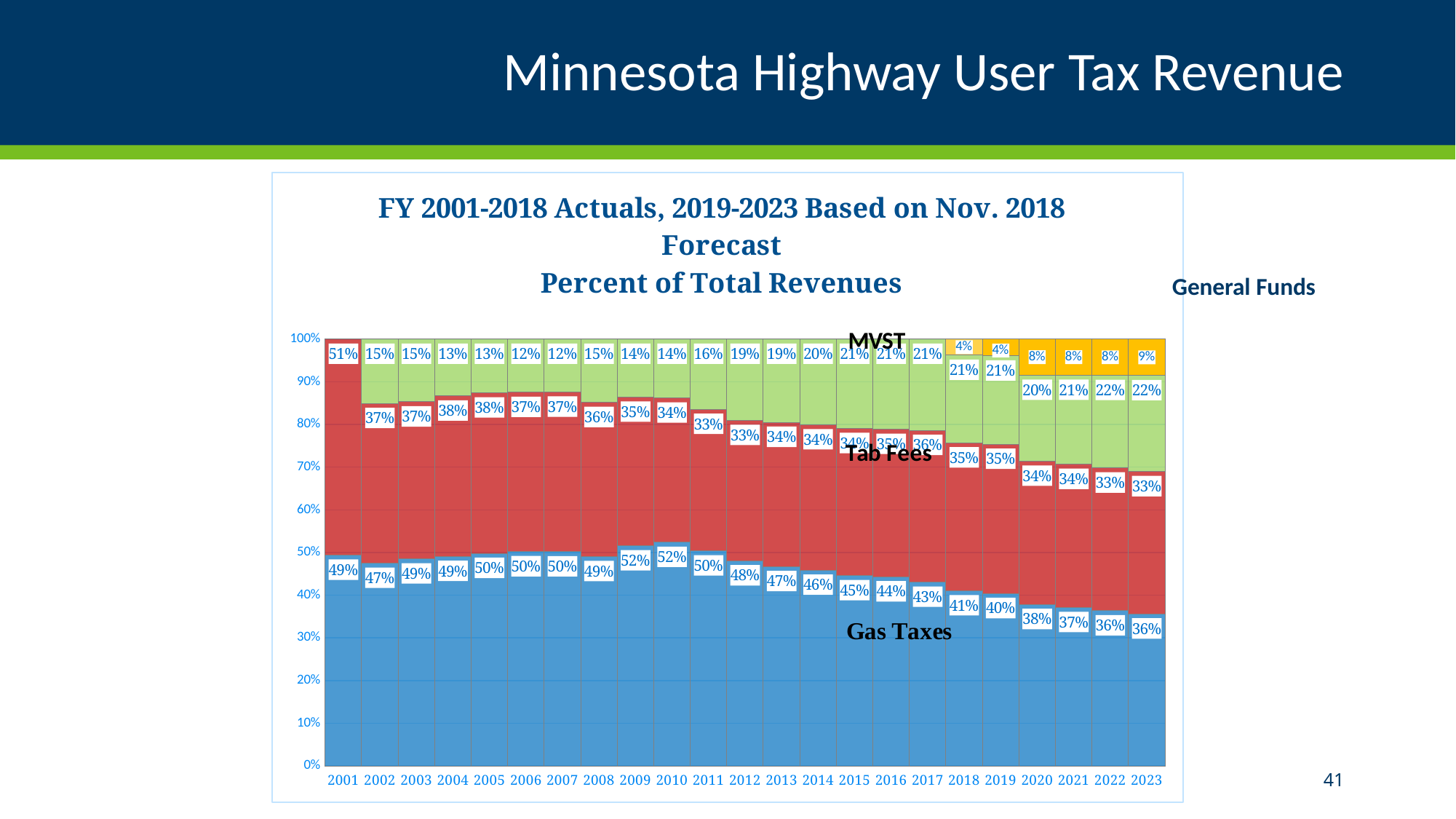
In which year is the Gas Taxes share lowest? 2022 and 2023 (36%) How many fiscal years are shown on the x axis? 23 What kind of chart is shown on the slide? Stacked bar chart What is the combined share of Gas Taxes and Tab Fees in 2023? 69% What is the Tab Fees share of total revenues in 2001? 51% Which is larger in 2002, the Gas Taxes share or the Tab Fees share? Gas Taxes What is the difference between the Gas Taxes share in 2009 and in 2023? 16 percentage points Does the Gas Taxes share rise or fall from 2010 to 2023? Fall What is the MVST share of total revenues in 2023? 22% What is the General Funds share of total revenues in 2018? 4% What is the Gas Taxes share of total revenues in 2010? 52%